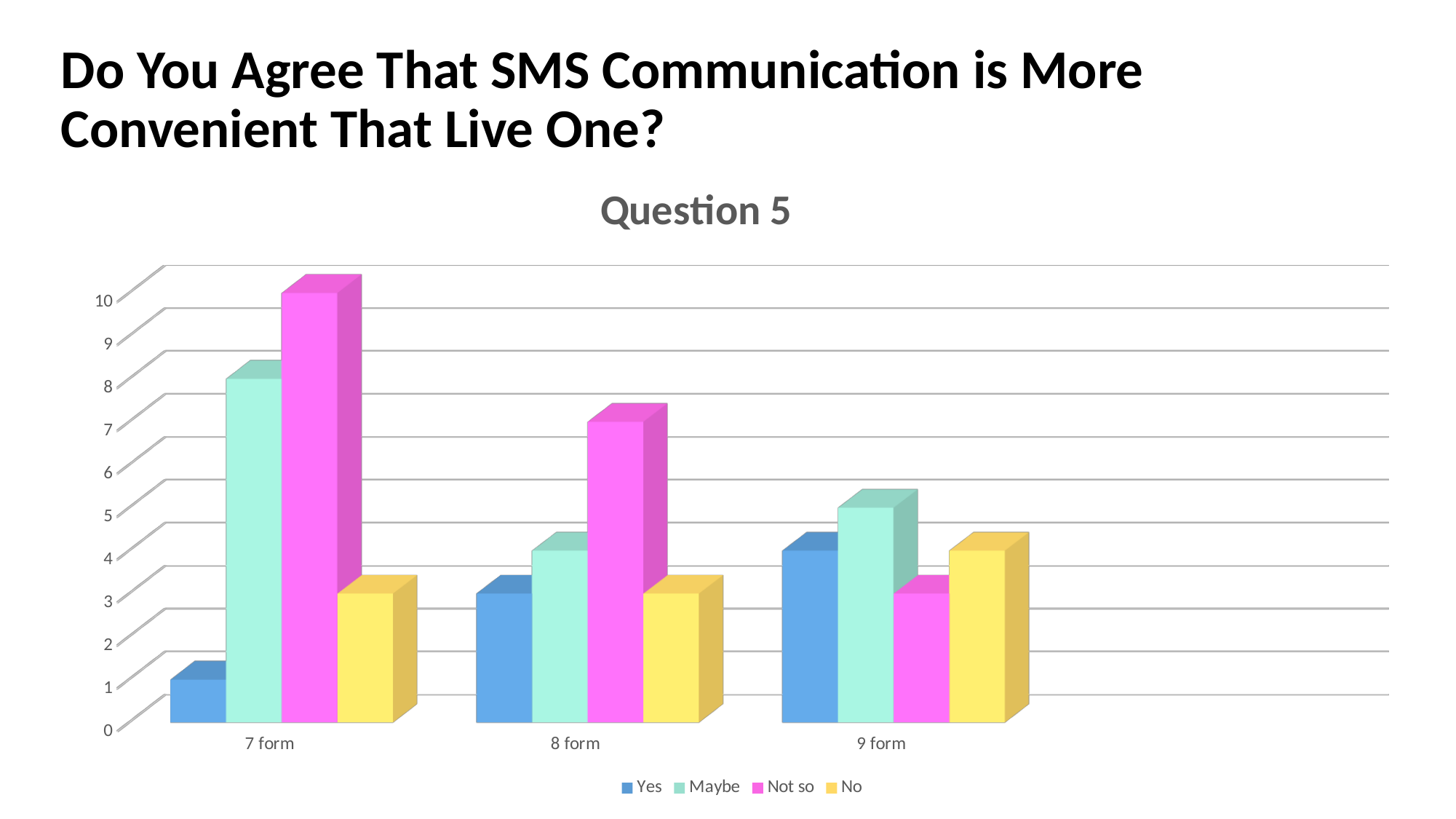
Is the value for Not so in 7 form greater or less than 9? greater Which series has the lowest value for 7 form? Yes Which series has the highest value for 8 form? Not so Which series has the lowest value for 9 form? Not so How many series does the legend list? 4 Does the Not so value rise or fall from 7 form to 9 form? fall What kind of chart is shown on the slide? bar chart How many categories are shown on the x axis? 3 Which is larger, the Maybe value for 7 form or the Maybe value for 9 form? 7 form Which series has the highest value for 7 form? Not so What is the title of the chart? Question 5 Is the value for Yes in 7 form greater or less than 2? less